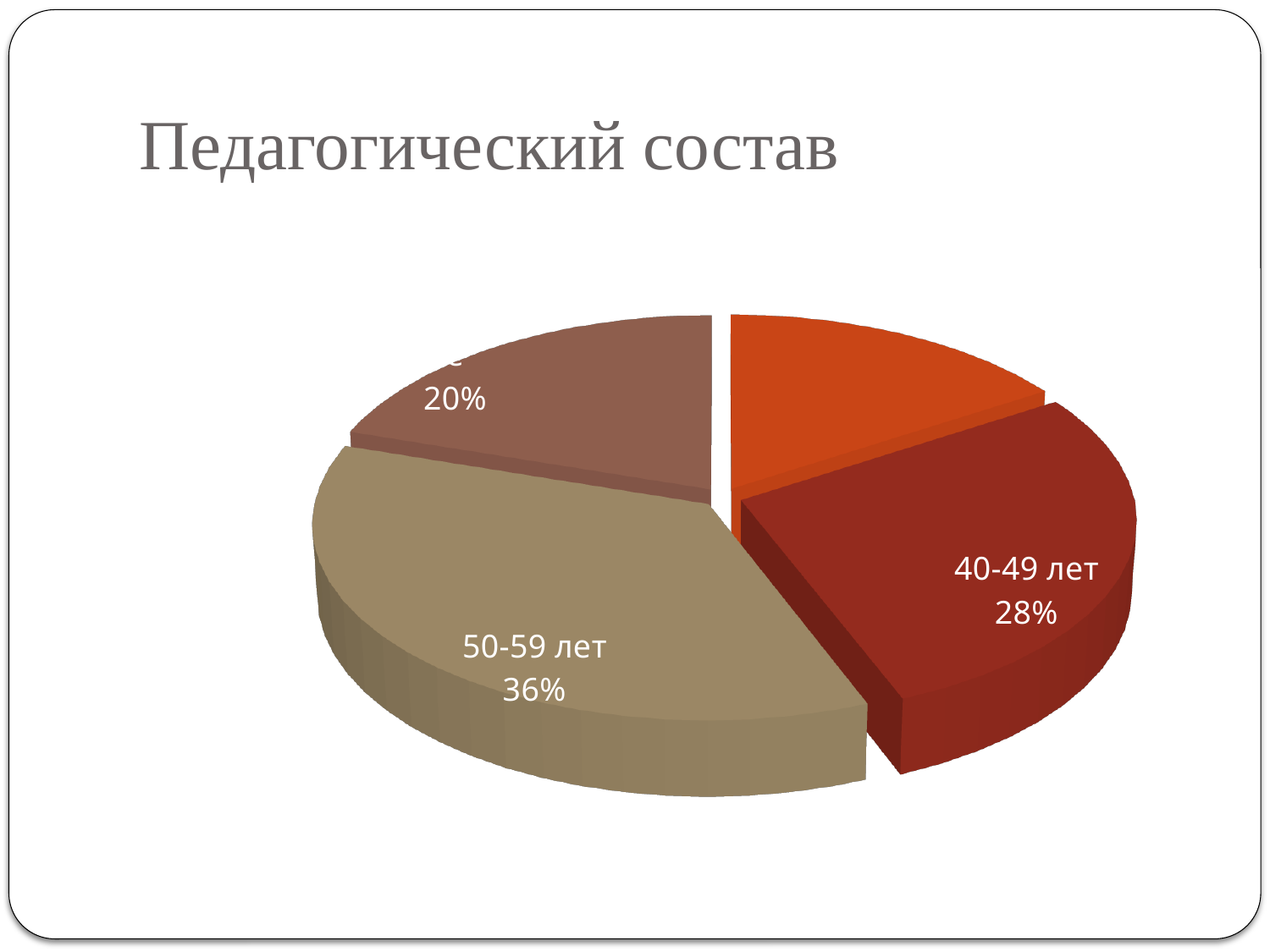
What percentage of the pie chart is the 50-59 лет slice? 36% Is the 40-49 лет slice larger or smaller than the 50-59 лет slice? smaller How many slices does the pie chart have? 4 What percentage of the pie chart is the 40-49 лет slice? 28% By how many percentage points does the 50-59 лет slice exceed the 40-49 лет slice? 8 What kind of chart is shown on the slide? Pie chart Which labelled age group has the largest slice of the pie chart? 50-59 лет What is the title of the slide containing the chart? Педагогический состав What share of the pie does the 50-59 лет slice represent? 36% Which is larger: the 40-49 лет slice or the 50-59 лет slice? 50-59 лет